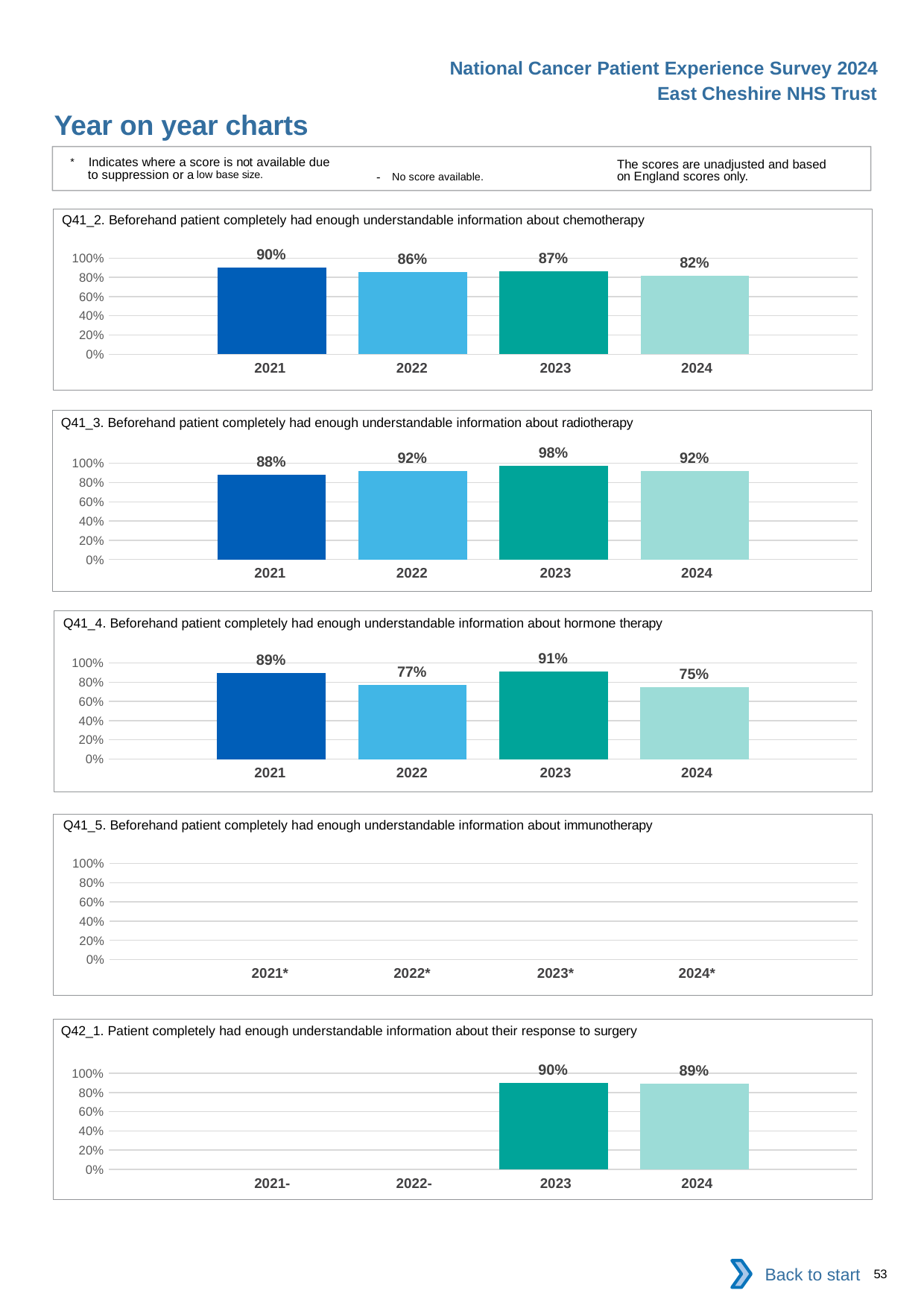
How many charts are shown on the slide? 5 In the Q41_4 chart (hormone therapy), what is the difference between the 2023 and 2024 values? 16 percentage points In the Q41_3 chart (radiotherapy), which year has the highest value? 2023 In the Q42_1 chart (response to surgery), what is the value for 2024? 89% In the Q41_3 chart (radiotherapy), what is the difference between the 2023 and 2021 values? 10 percentage points In the Q41_4 chart (hormone therapy), what is the value for 2022? 77% In the Q42_1 chart (response to surgery), how many years have a plotted bar? 2 In the Q41_2 chart (chemotherapy), which year has the lowest value? 2024 What type of chart is the Q41_2 chart (chemotherapy)? Bar chart In the Q41_2 chart (chemotherapy), what is the value for 2021? 90% In the Q41_5 chart (immunotherapy), how many years have a plotted bar? 0 In the Q41_4 chart (hormone therapy), which is larger, the 2021 value or the 2024 value? 2021